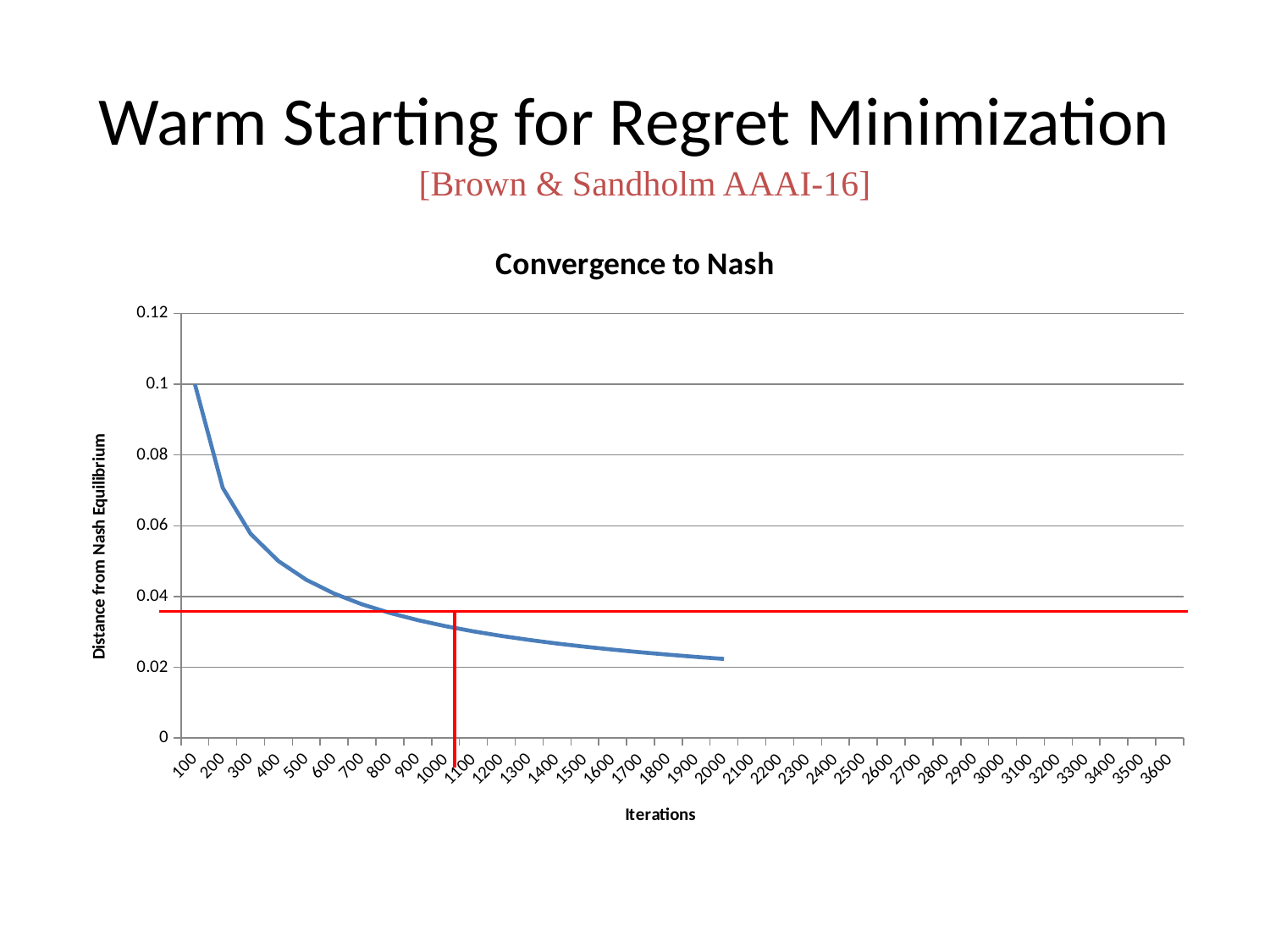
What is the highest value shown on the y axis of the chart? 0.12 Does the distance from Nash equilibrium rise or fall as the number of iterations increases? Fall What is the label of the y axis of the chart? Distance from Nash Equilibrium Is the distance from Nash equilibrium at 100 iterations greater or less than 0.08? greater What is the distance from Nash equilibrium at 100 iterations? 0.1 Is the distance from Nash equilibrium at 500 iterations greater or less than 0.04? greater At which number of iterations is the distance from Nash equilibrium highest? 100 What is the title of the chart? Convergence to Nash Is the distance from Nash equilibrium at 2000 iterations greater or less than 0.04? less What kind of chart is shown on the slide? Line chart Which has a larger distance from Nash equilibrium: 300 iterations or 1500 iterations? 300 iterations